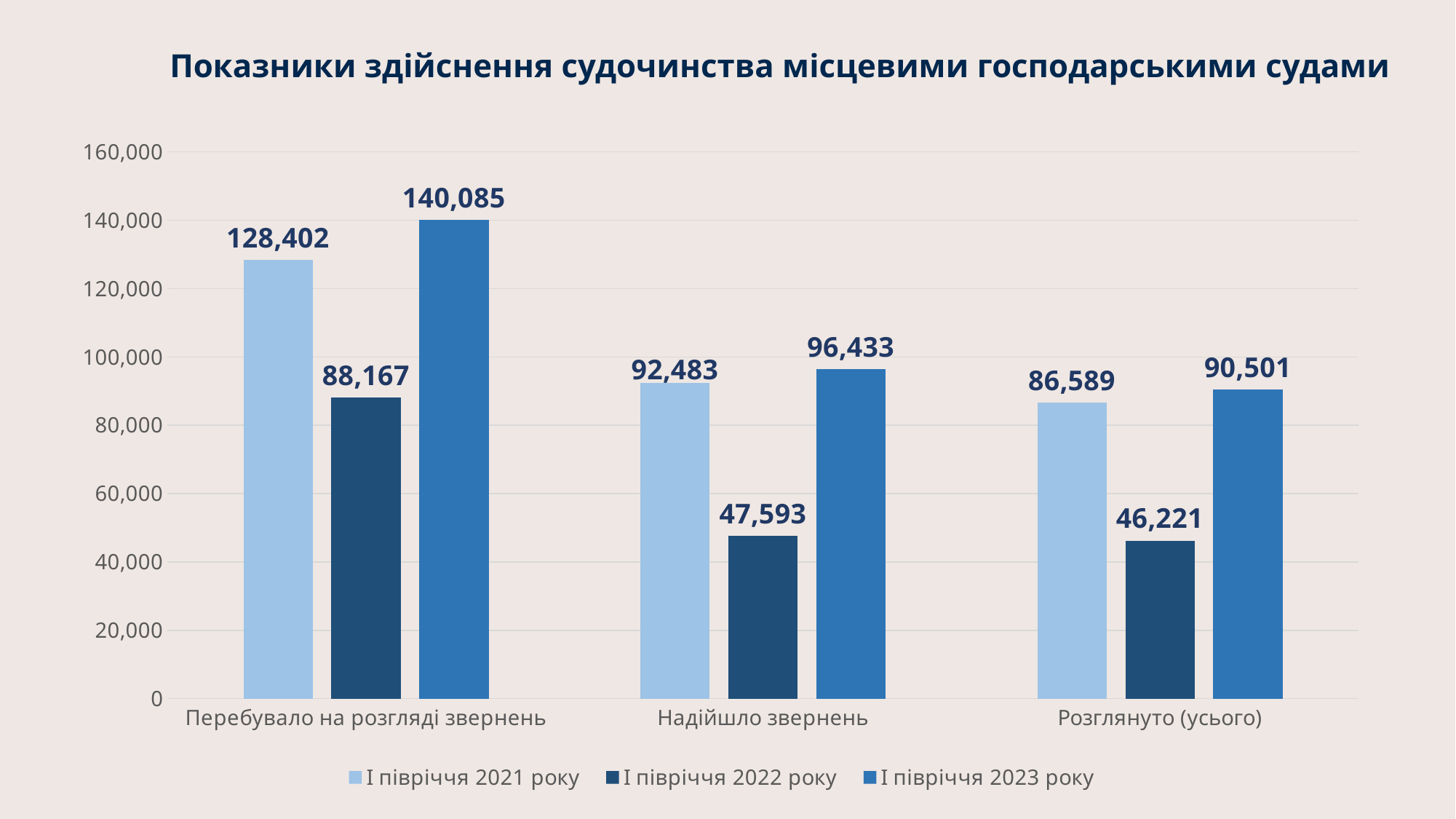
Which is larger for 'Розглянуто (усього)': the 'І півріччя 2021 року' value or the 'І півріччя 2023 року' value? І півріччя 2023 року How many series does the legend list? 3 What type of chart is shown on the slide? Bar chart What is the difference between the 'І півріччя 2023 року' and 'І півріччя 2021 року' values for 'Перебувало на розгляді звернень'? 11,683 How many categories are shown on the x axis? 3 Which category has the highest value in the 'І півріччя 2022 року' series? Перебувало на розгляді звернень What is the difference between the 'І півріччя 2021 року' and 'І півріччя 2022 року' values for 'Надійшло звернень'? 44,890 What is the value for 'Розглянуто (усього)' in the 'І півріччя 2021 року' series? 86,589 Which category has the lowest value in the 'І півріччя 2023 року' series? Розглянуто (усього) What is the value for 'Надійшло звернень' in the 'І півріччя 2022 року' series? 47,593 What is the value for 'Перебувало на розгляді звернень' in the 'І півріччя 2023 року' series? 140,085 What is the title of the chart? Показники здійснення судочинства місцевими господарськими судами